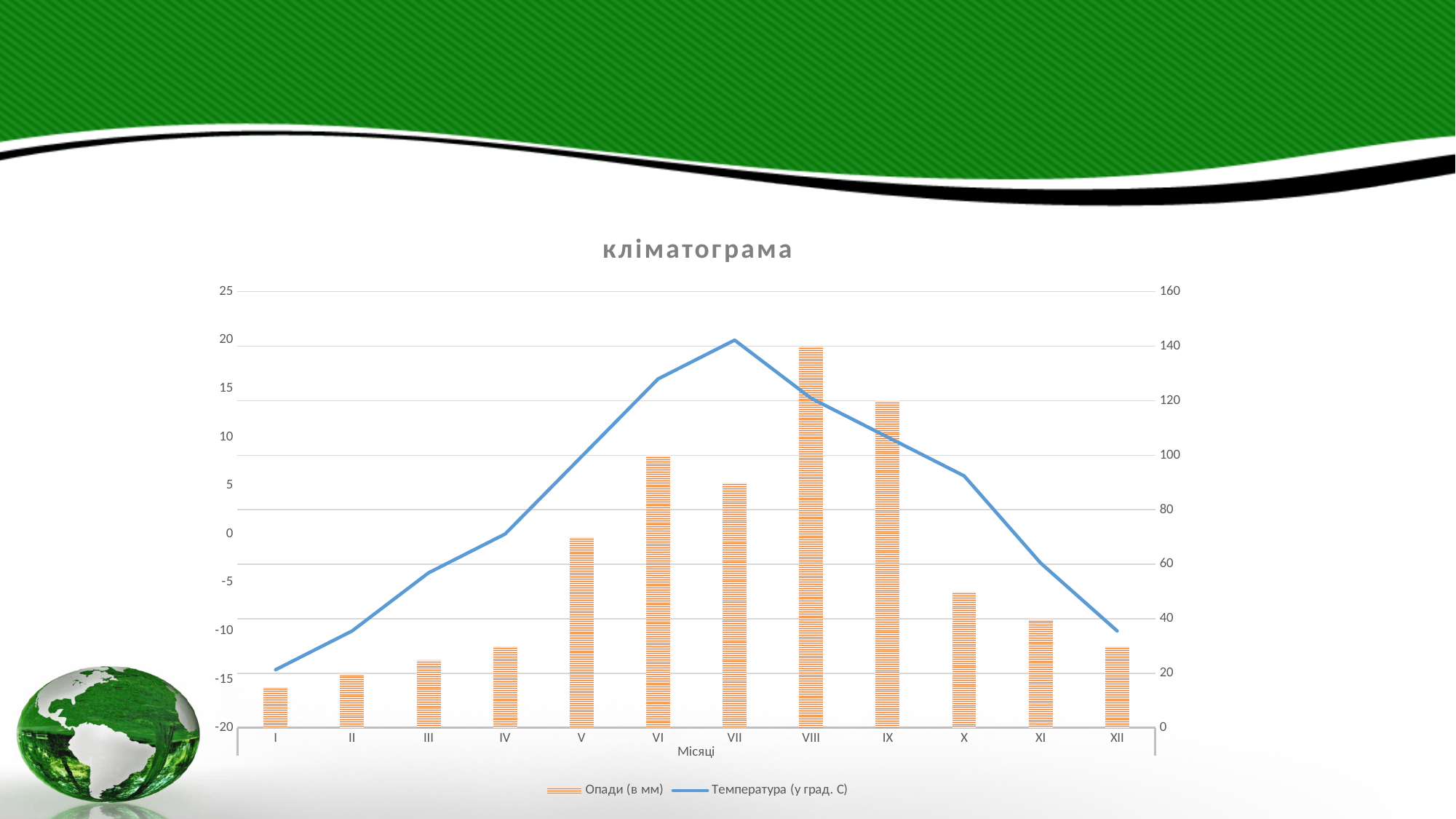
What kind of chart is this? Combination bar and line chart Is the precipitation value for month VIII greater or less than 120? greater How many series does the legend list? 2 Is the temperature value for month I greater or less than -10? less Which month has the highest precipitation (Опади) bar? VIII What is the title of the chart? кліматограма Which month has the larger precipitation bar, VIII or IX? VIII Which month has the lowest precipitation (Опади) bar? I What is the label of the x axis? Місяці Which month has the highest temperature (Температура) on the line? VII Does the temperature line rise or fall from month I to month VII? rise How many months (categories) are shown on the x axis? 12